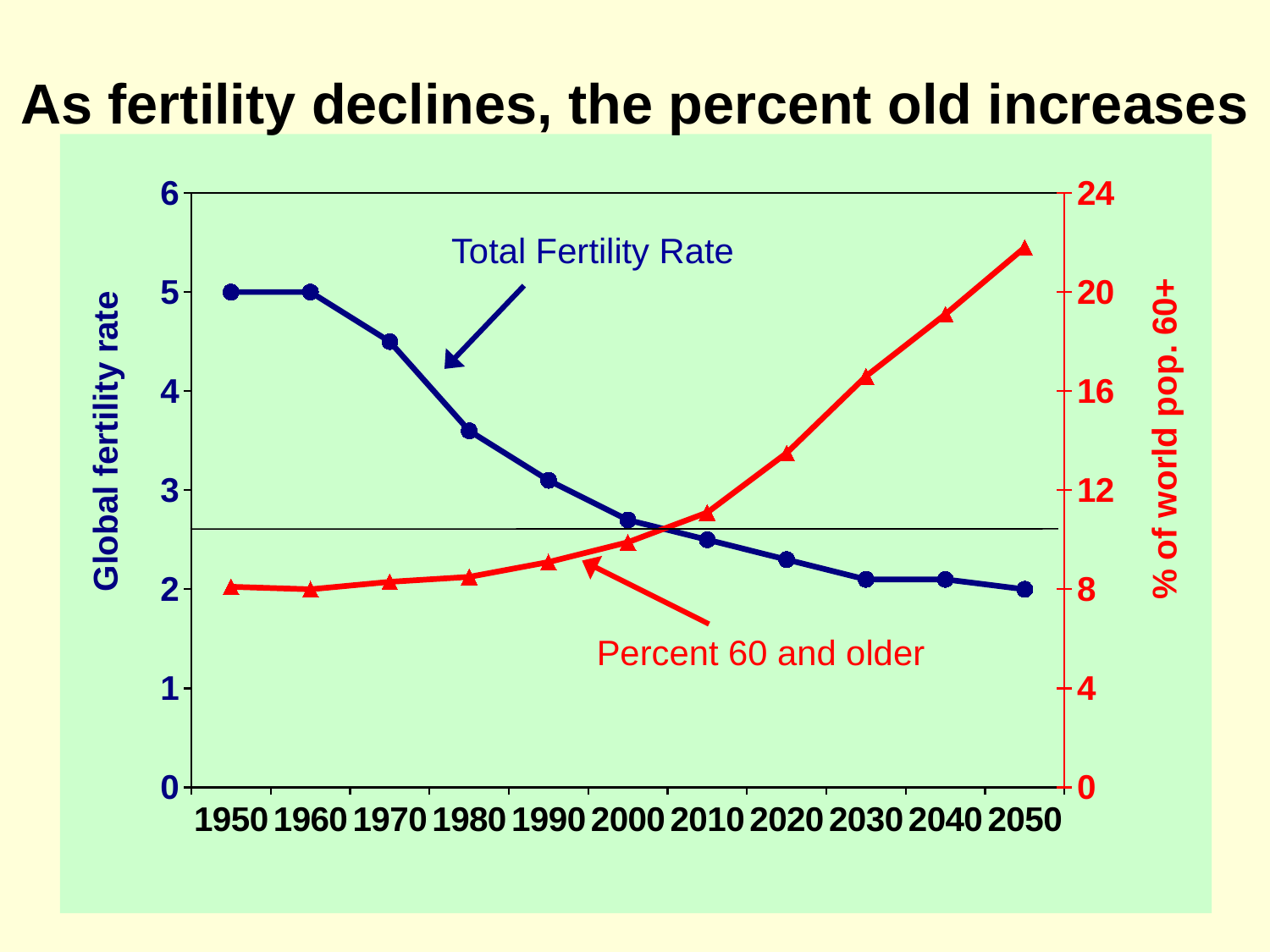
Is the percent of world population 60 and older in 2020 greater or less than 12? greater Is the percent of world population 60 and older in 2050 greater or less than 20? greater Is the Total Fertility Rate in 1970 greater or less than 4? greater What is the label of the right-hand vertical axis? % of world pop. 60+ What kind of chart is shown on the slide? line chart In which year is the percent of world population 60 and older highest? 2050 How many years are plotted along the x axis? 11 What is the Total Fertility Rate in 2050? 2 Does the Total Fertility Rate rise or fall from 1950 to 2050? fall What is the Total Fertility Rate in 1950? 5